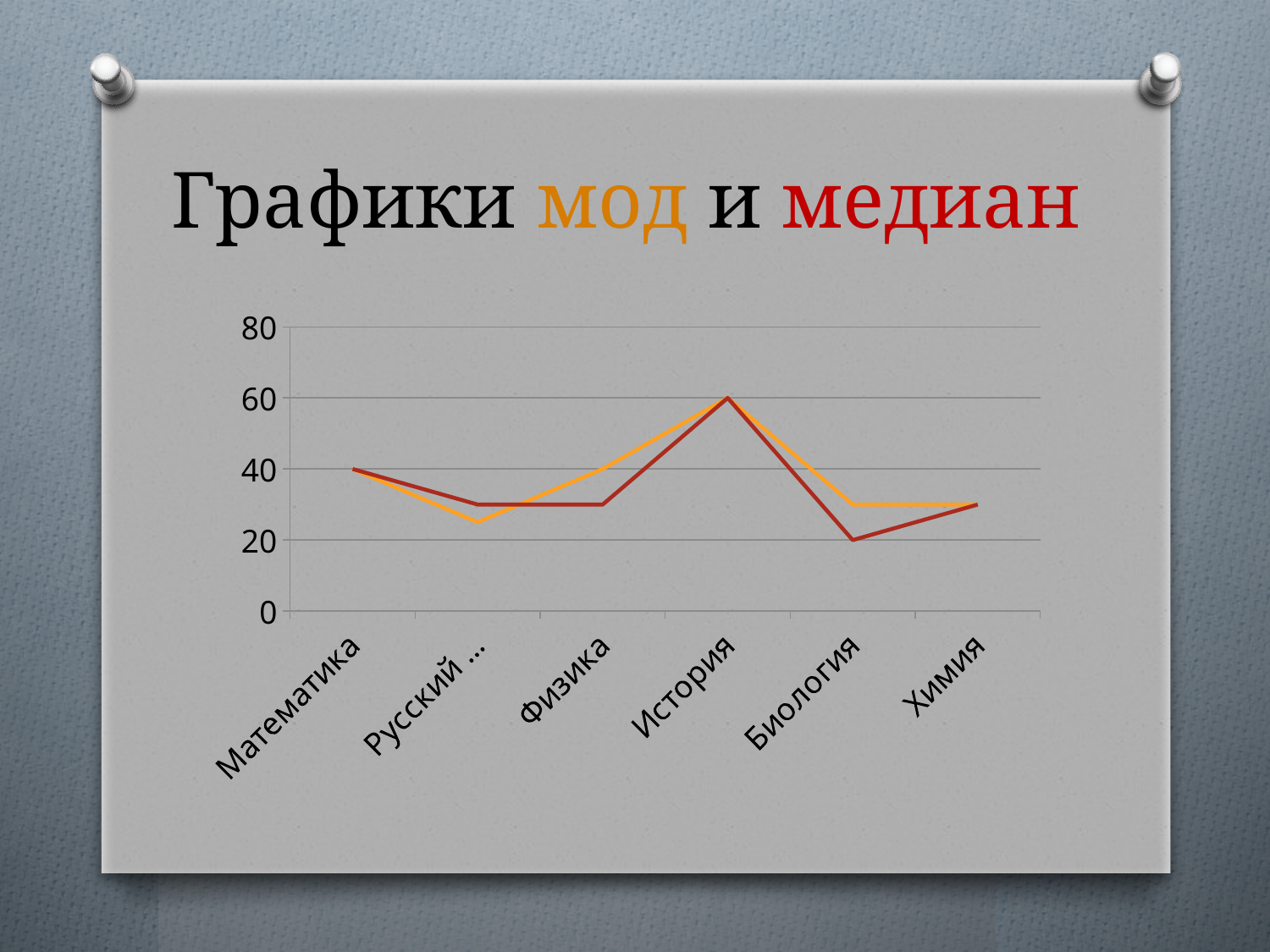
What is the title of the slide containing the chart? Графики мод и медиан Do the lines rise or fall from Физика to История? rise Is the value of the orange line for Русский ... greater or less than 40? less For which category does the red line reach its lowest value? Биология For which category does the orange line reach its highest value? История What is the value of the red line for Биология? 20 How many categories are shown on the x axis of the chart? 6 At Биология, which line has the larger value, the orange line or the red line? orange line What kind of chart is shown on the slide? line chart What is the value of the red line for История? 60 What is the value of the red line for Математика? 40 What is the difference between the red line's values for История and Математика? 20